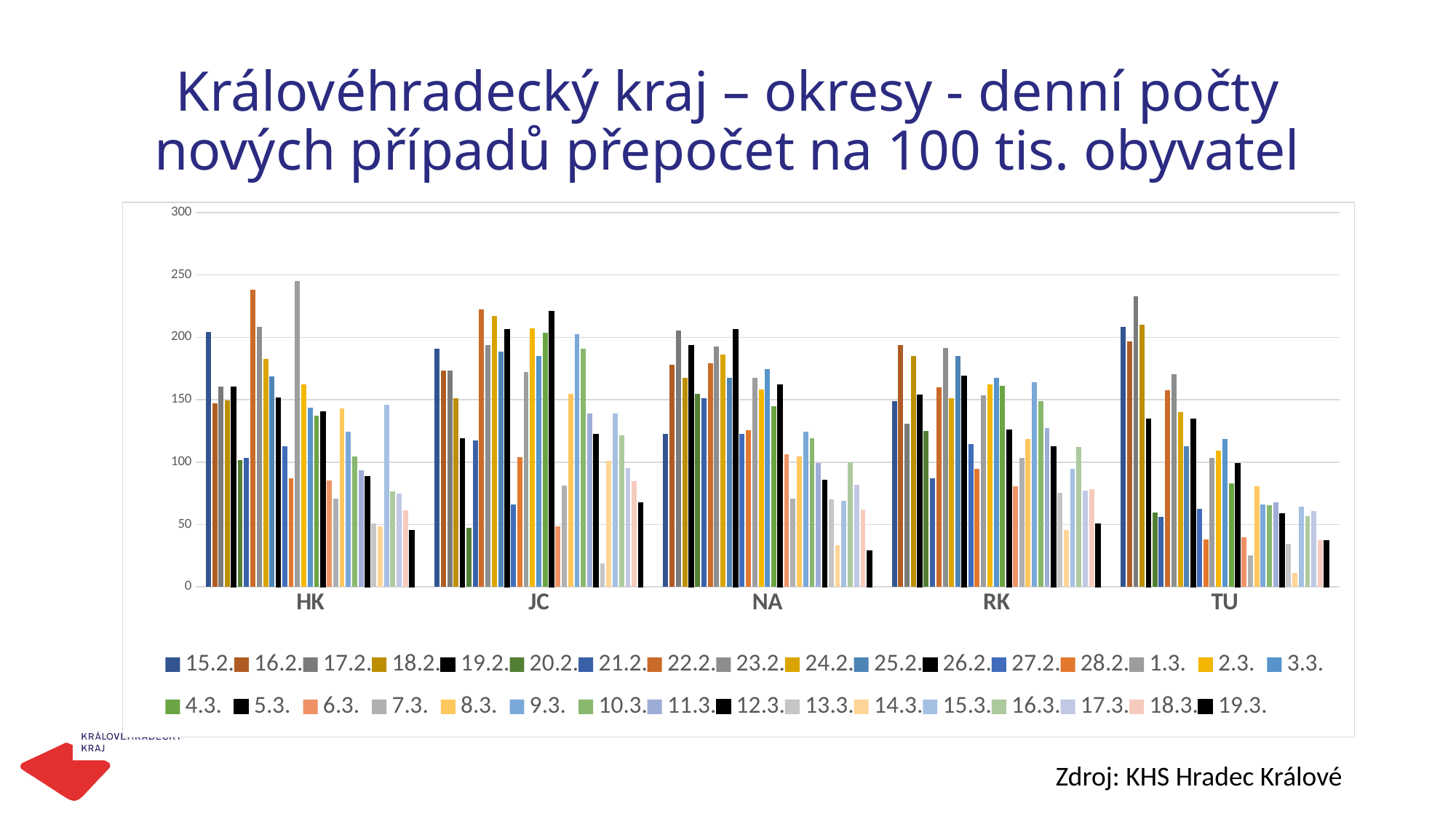
What is the highest value shown on the chart's vertical axis? 300 What is the first series listed in the chart's legend? 15.2. Is the value of the first bar (15.2.) for NA greater or less than 100? greater How many categories (districts) are shown on the x axis of the chart? 5 Is the value of the last bar (19.3.) for NA greater or less than 50? less Is the value of the last bar (19.3.) for HK greater or less than 50? less How many series does the chart's legend list? 33 What kind of chart is shown on the slide? bar chart Which category contains the tallest bar in the chart? HK